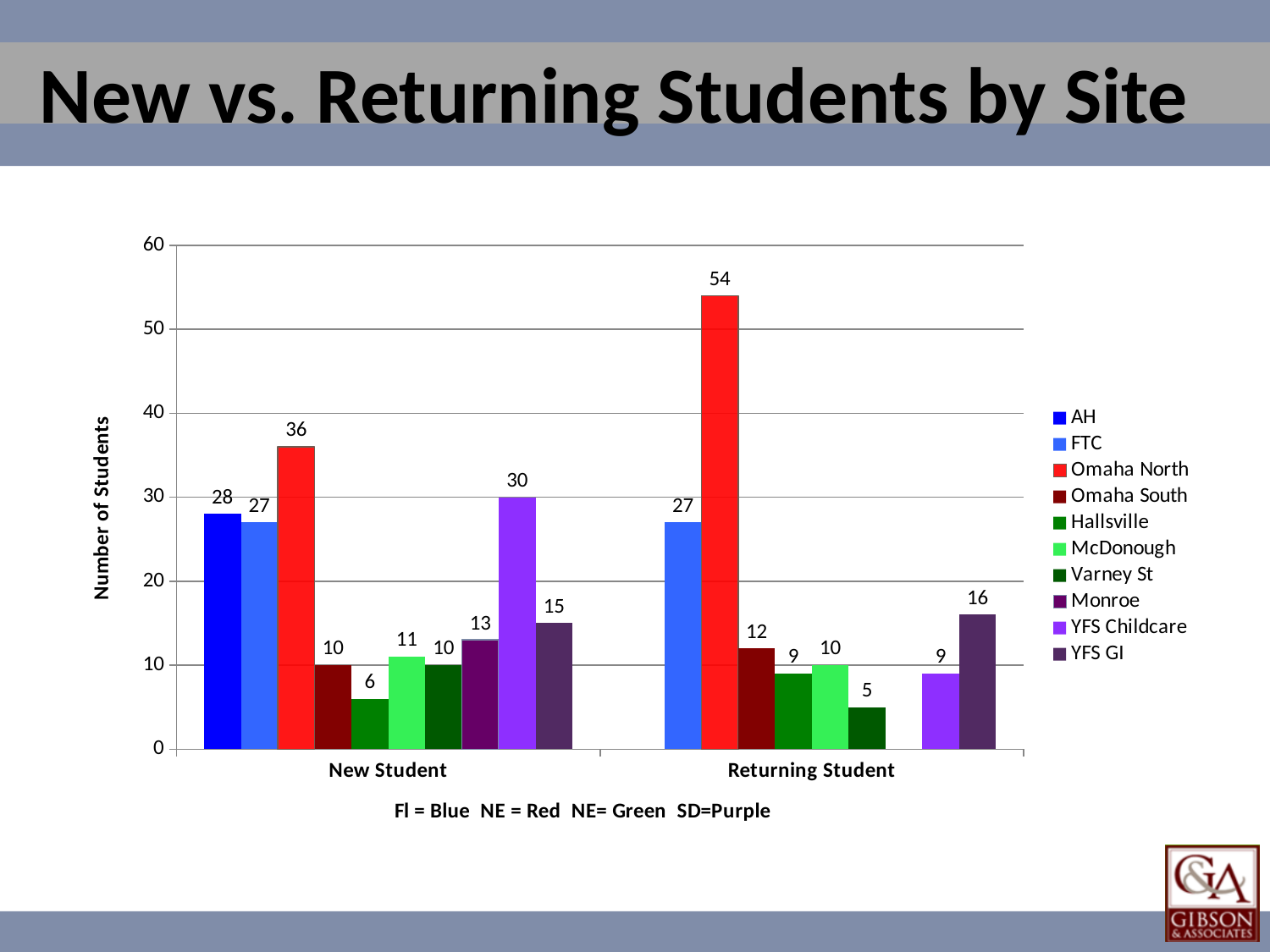
Which site has the lowest value in the New Student category? Hallsville What is the title of the y axis? Number of Students Which site has the lowest value in the Returning Student category? Varney St Which is larger in the New Student category: AH or FTC? AH What is the value for Varney St in the Returning Student category? 5 What is the value for Omaha North in the Returning Student category? 54 What is the difference between Omaha North's Returning Student value and its New Student value? 18 How many categories are shown on the x axis? 2 What kind of chart is shown on the slide? Bar chart Which site has the highest value in the Returning Student category? Omaha North What is the value for YFS Childcare in the New Student category? 30 How many series does the legend list? 10